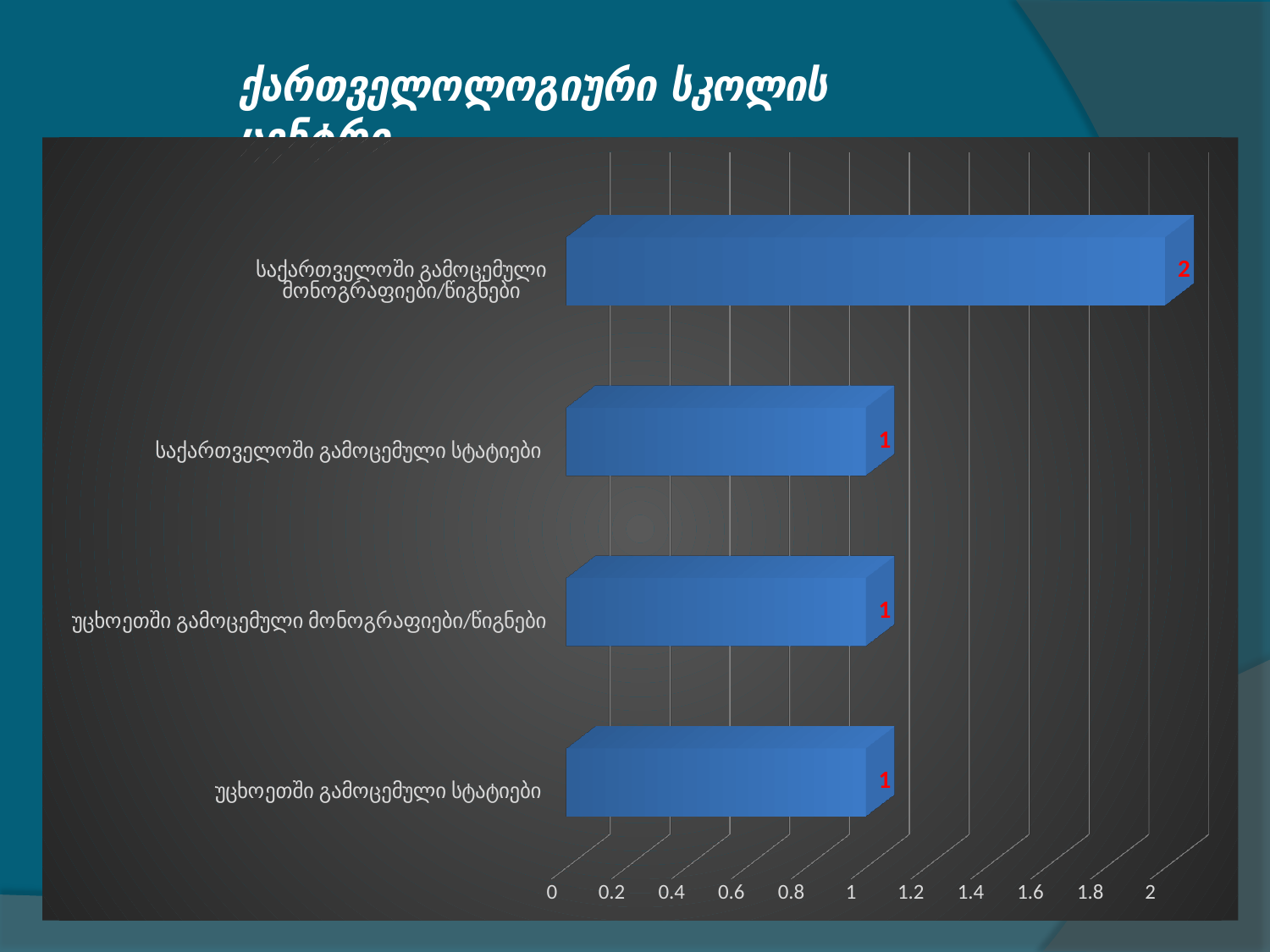
Which is larger, the value for საქართველოში გამოცემული მონოგრაფიები/წიგნები or the value for უცხოეთში გამოცემული სტატიები? საქართველოში გამოცემული მონოგრაფიები/წიგნები What is the highest tick value shown on the value axis? 2 Which category has the highest value? საქართველოში გამოცემული მონოგრაფიები/წიგნები What is the value for უცხოეთში გამოცემული სტატიები? 1 What is the difference between the values for საქართველოში გამოცემული მონოგრაფიები/წიგნები and საქართველოში გამოცემული სტატიები? 1 What is the value for უცხოეთში გამოცემული მონოგრაფიები/წიგნები? 1 What is the value for საქართველოში გამოცემული სტატიები? 1 What kind of chart is shown on the slide? bar chart Is the value for საქართველოში გამოცემული მონოგრაფიები/წიგნები greater or less than 1.6? greater Is the value for უცხოეთში გამოცემული სტატიები greater or less than 1.4? less How many categories are shown in the chart? 4 What is the value for საქართველოში გამოცემული მონოგრაფიები/წიგნები? 2